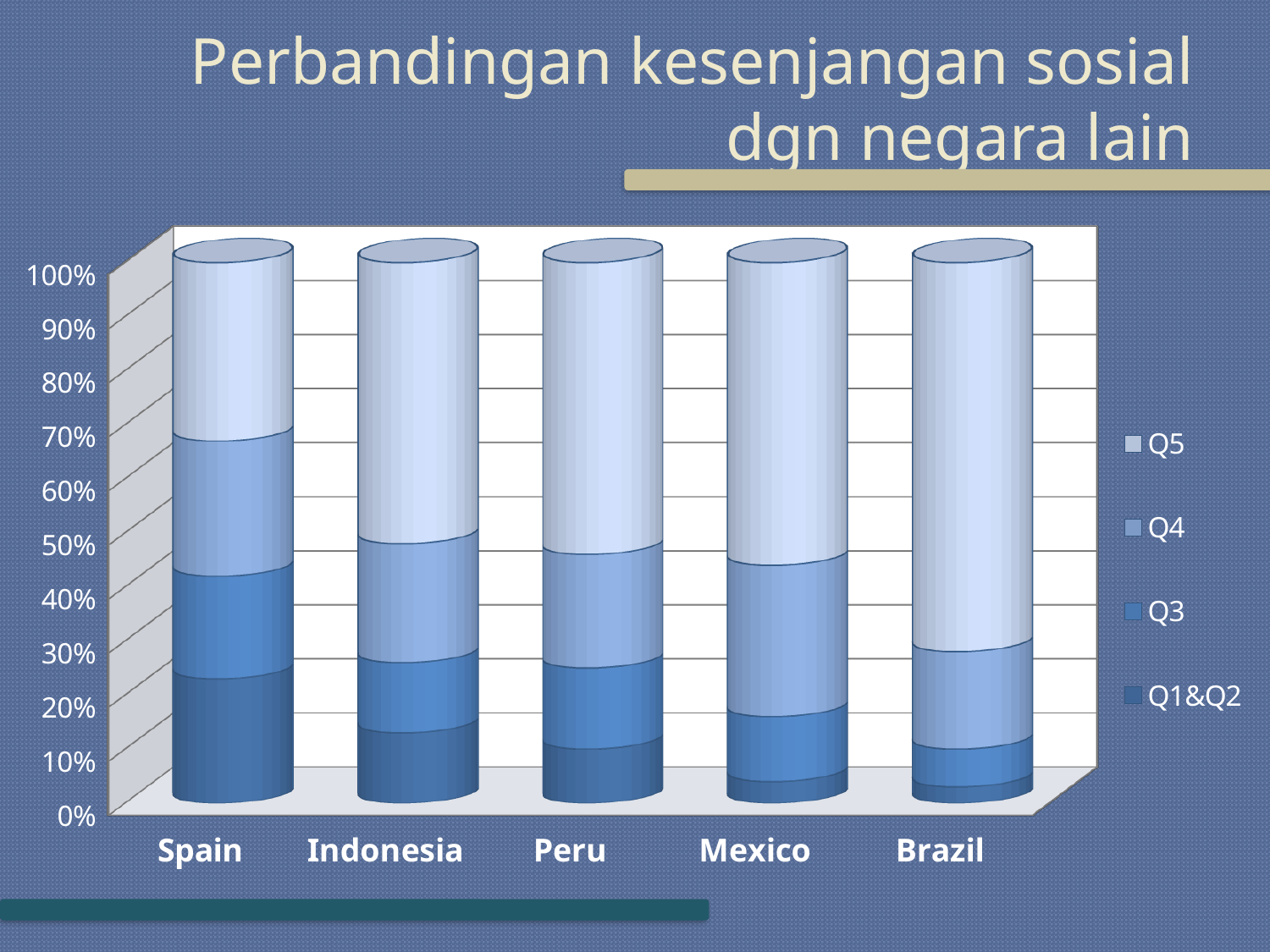
Which country has the smallest Q1&Q2 segment? Brazil Which country has the largest Q1&Q2 segment? Spain Is the Q1&Q2 segment for Spain greater or less than 20%? greater Is the Q1&Q2 segment for Brazil greater or less than 10%? less How many series does the chart legend list? 4 Which country has a larger Q5 segment, Spain or Mexico? Mexico What kind of chart is shown on the slide? Stacked bar chart Which country has the largest Q5 segment? Brazil What is the title of the slide containing the chart? Perbandingan kesenjangan sosial dgn negara lain Does the Q1&Q2 segment rise or fall moving from Spain to Brazil along the x axis? Fall How many countries are shown on the x axis of the chart? 5 Which series is listed last in the chart legend? Q1&Q2